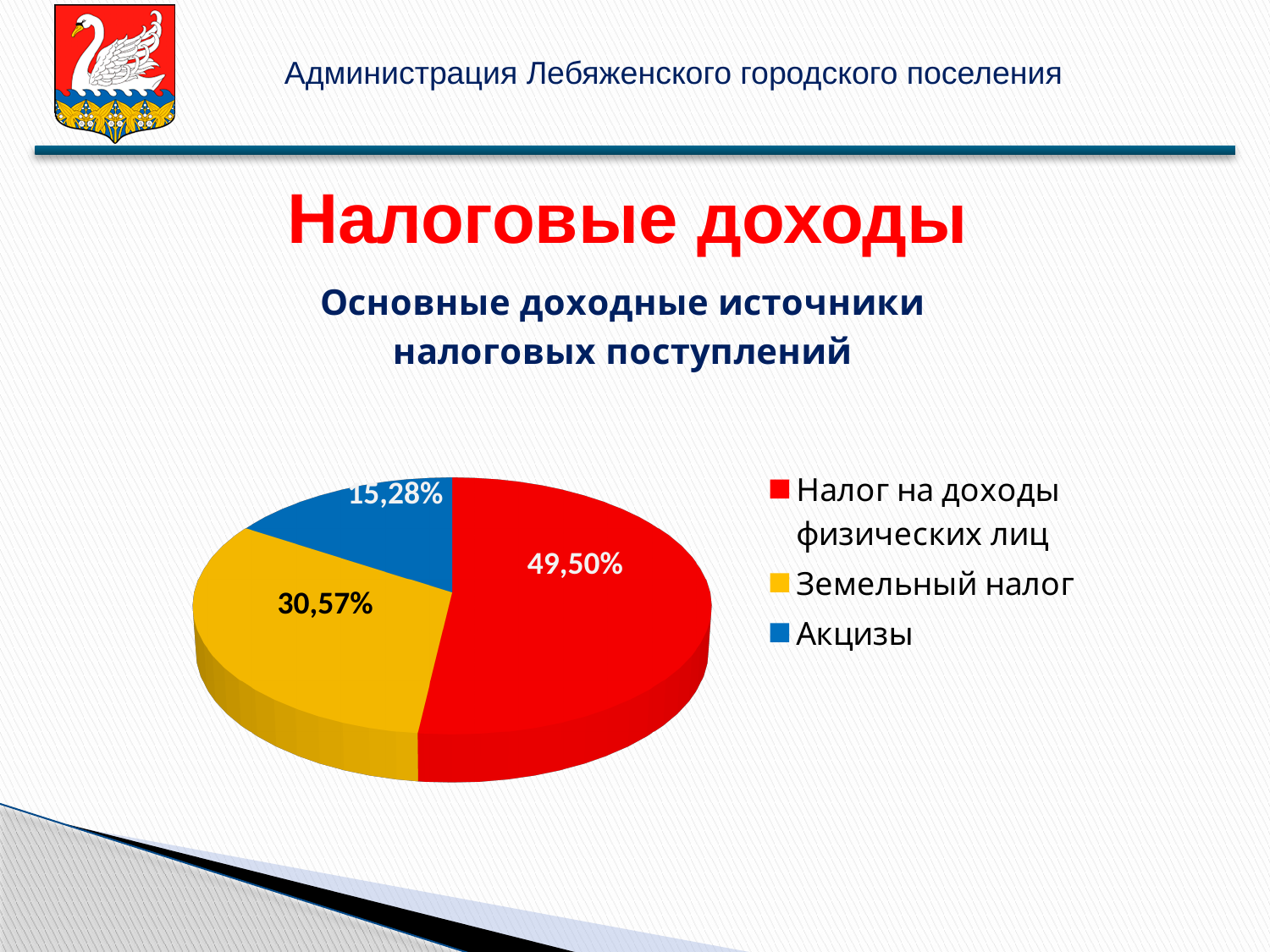
What kind of chart is shown on the slide? pie chart How many slices does the pie chart have? 3 What is the subtitle above the chart? Основные доходные источники налоговых поступлений What share of the pie does Акцизы have? 15,28% What colour is the slice for Акцизы? blue Which category has the largest slice of the pie? Налог на доходы физических лиц What share of the pie does Земельный налог have? 30,57% Which category has the smallest slice of the pie? Акцизы What is the difference between the share for Земельный налог and the share for Акцизы? 15,29% What is the difference between the share for Налог на доходы физических лиц and the share for Земельный налог? 18,93% What share of the pie does Налог на доходы физических лиц have? 49,50% Which is larger, the share for Земельный налог or the share for Акцизы? Земельный налог